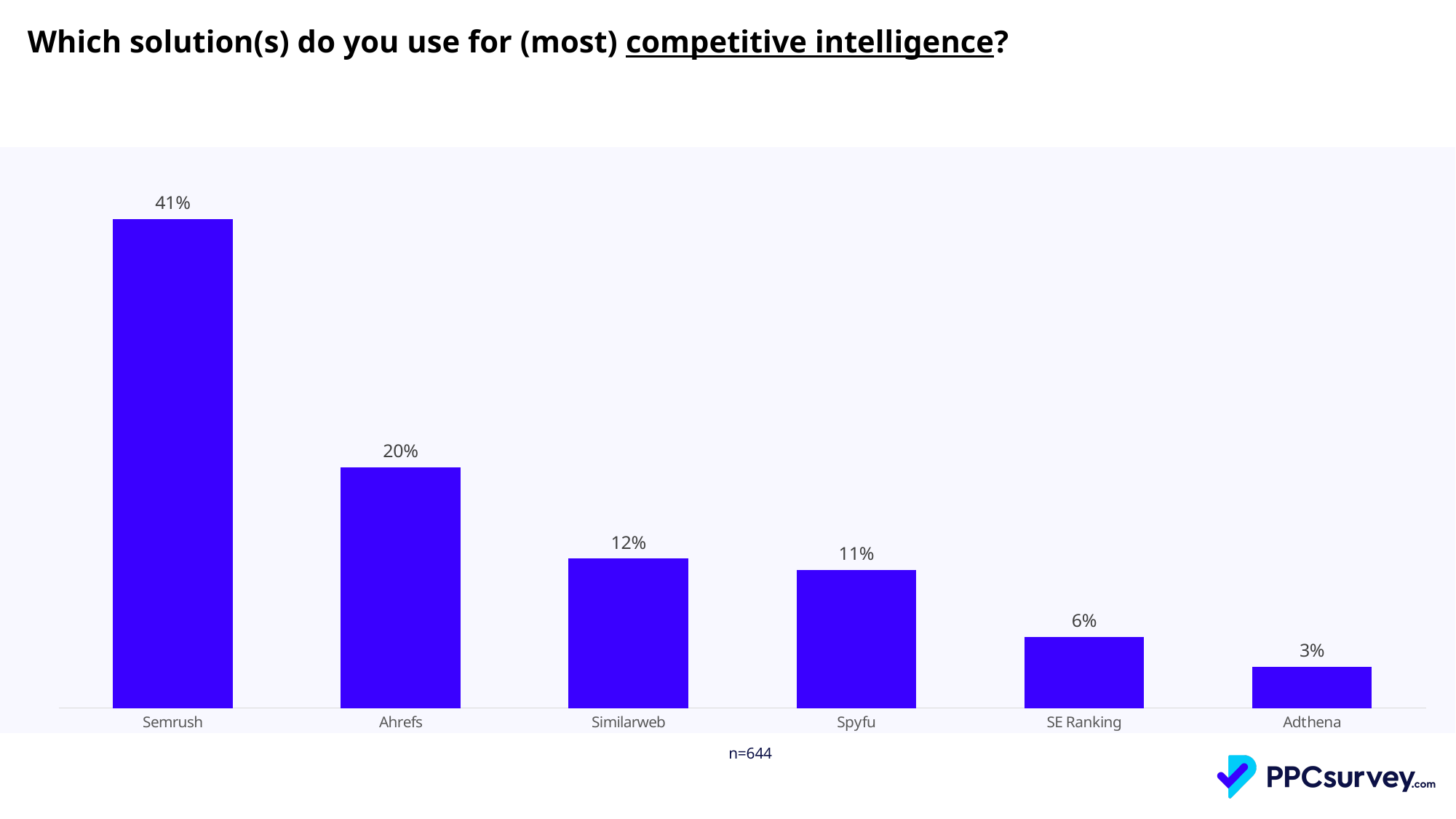
Which solution has the lowest percentage? Adthena Which has a larger value, Similarweb or SE Ranking? Similarweb What type of chart is shown on the slide? Bar chart What is the difference between the values for Spyfu and Adthena? 8% What is the value shown for SE Ranking? 6% What is the sample size (n) noted below the chart? n=644 Which solution has the highest percentage? Semrush What percentage of respondents use Semrush for competitive intelligence? 41% What is the value shown for Similarweb? 12% What is the value shown for Ahrefs? 20% What is the difference between the values for Semrush and Ahrefs? 21% How many solutions are shown in the chart? 6